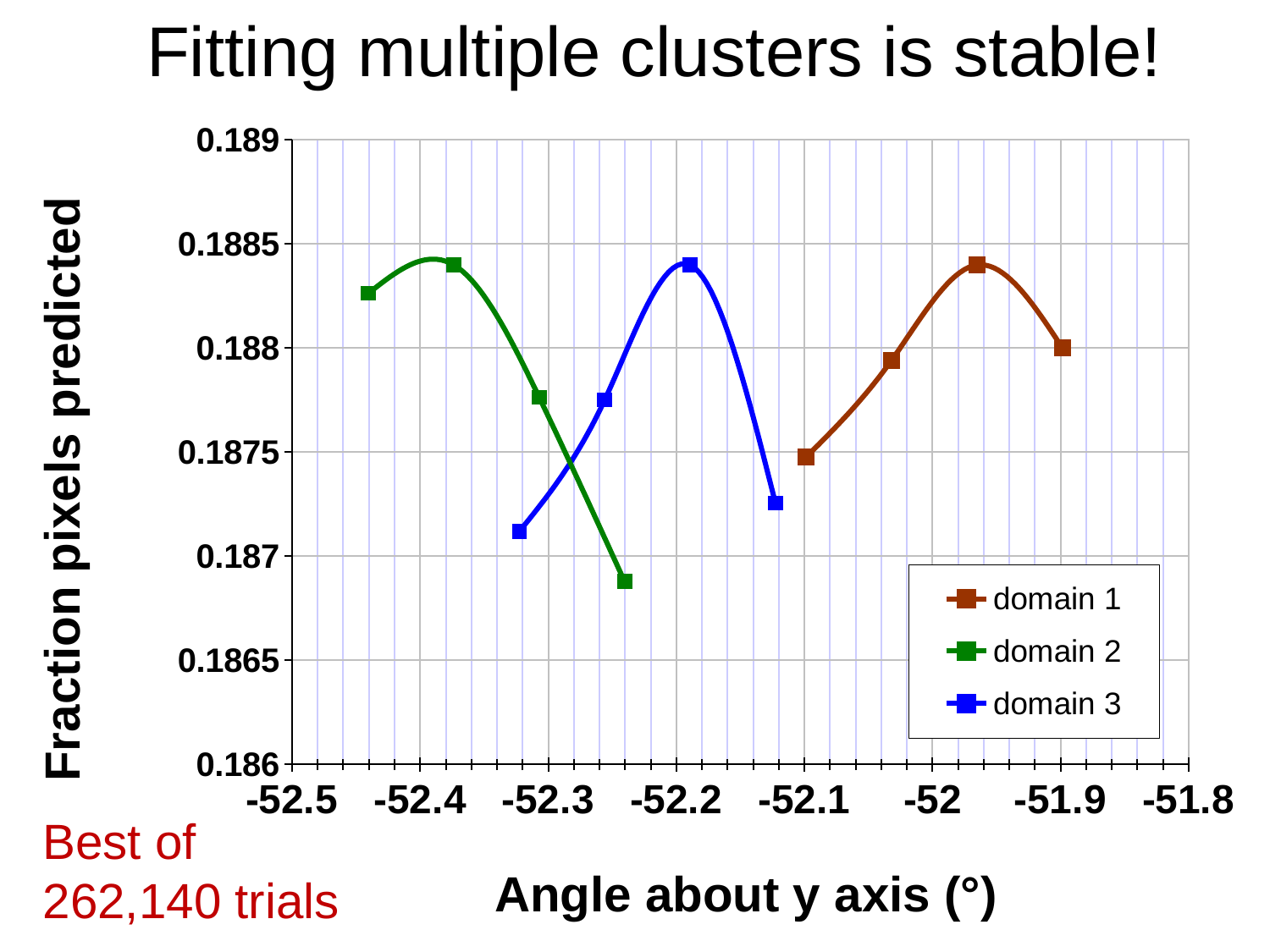
Is the lowest value of domain 2 greater or less than 0.1875? less How many data points are plotted for domain 2? 4 Which series reaches the lowest value on the chart? domain 2 What is the title of the chart? Fitting multiple clusters is stable! How many data points are plotted for domain 1? 4 Is the peak value of domain 1 greater or less than 0.188? greater Is the leftmost point of domain 2 greater or less than 0.188? greater How many series does the legend list? 3 What is the label of the x axis? Angle about y axis (°) What kind of chart is shown on the slide? line chart Which series is plotted furthest to the right along the x axis? domain 1